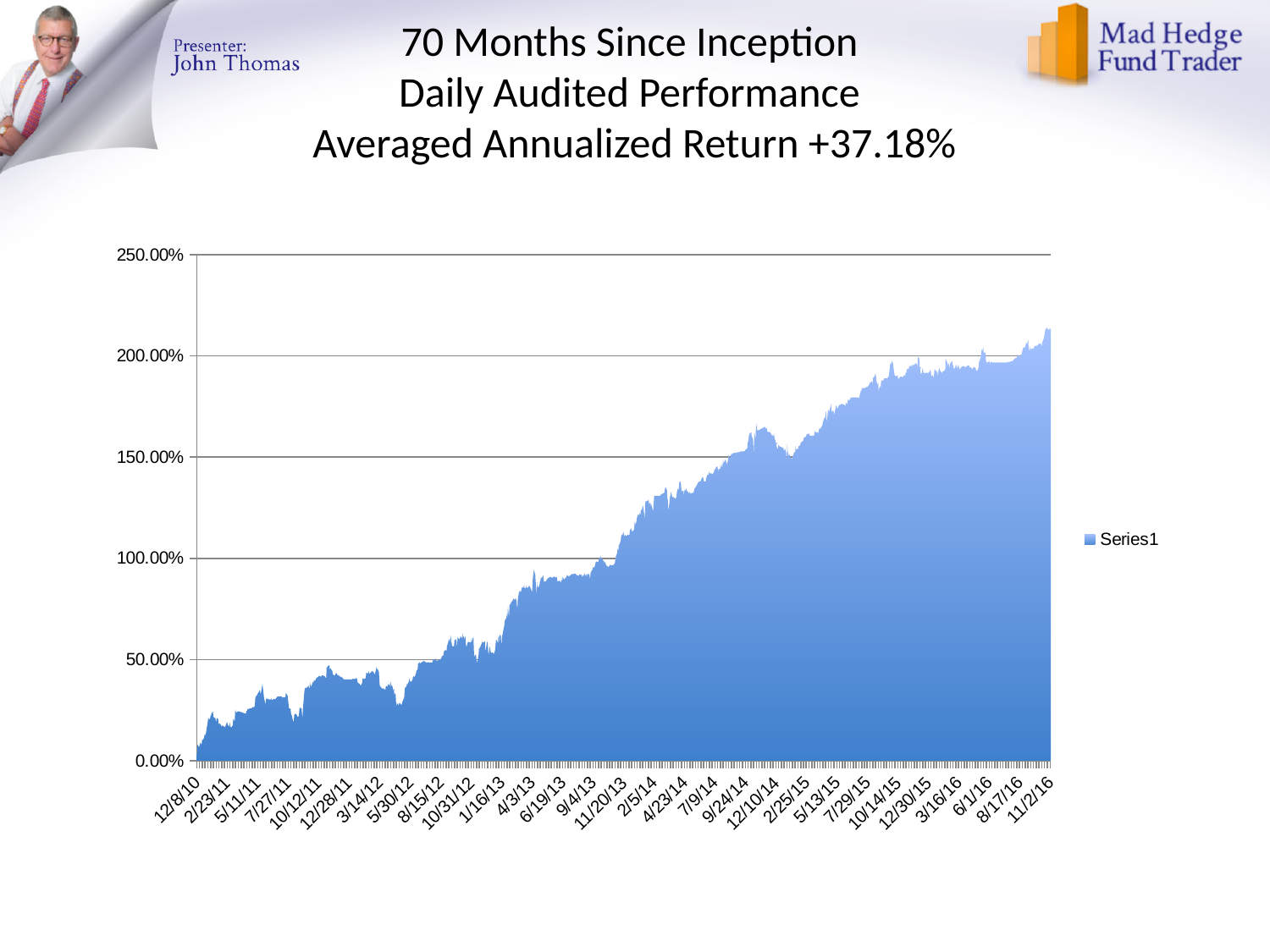
Is the value at 2/5/14 greater or less than 100.00%? greater What is the highest value shown on the vertical axis? 250.00% Is the value at 7/29/15 greater or less than 200.00%? less What is the name of the series shown in the legend? Series1 Do the values generally rise or fall from 12/8/10 to 11/2/16? rise Is the value at 11/2/16 greater or less than 200.00%? greater How many series does the legend list? 1 What kind of chart is shown on the slide? area chart